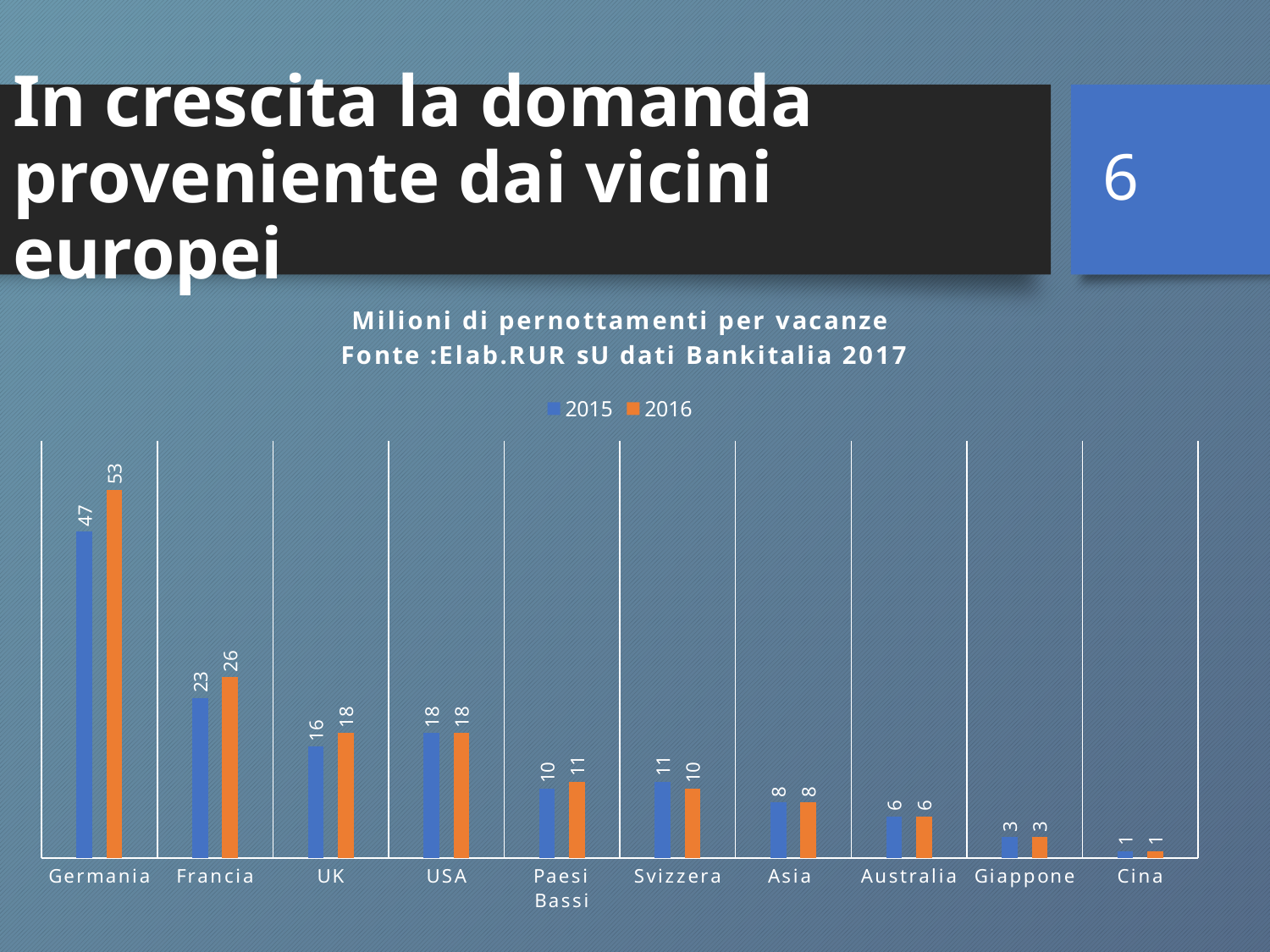
Which series is shown in orange in the legend? 2016 What is the difference between the 2016 and 2015 values for Germania? 6 Which category has the lowest 2015 value? Cina What is the 2016 value for Paesi Bassi? 11 What is the difference between the 2016 values for Francia and UK? 8 What is the 2015 value for Francia? 23 What kind of chart is shown on the slide? Bar chart Which category has the highest 2016 value? Germania How many series does the legend list? 2 What is the 2016 value for Germania? 53 Which is larger for Svizzera, the 2015 value or the 2016 value? 2015 How many categories are shown on the x axis? 10